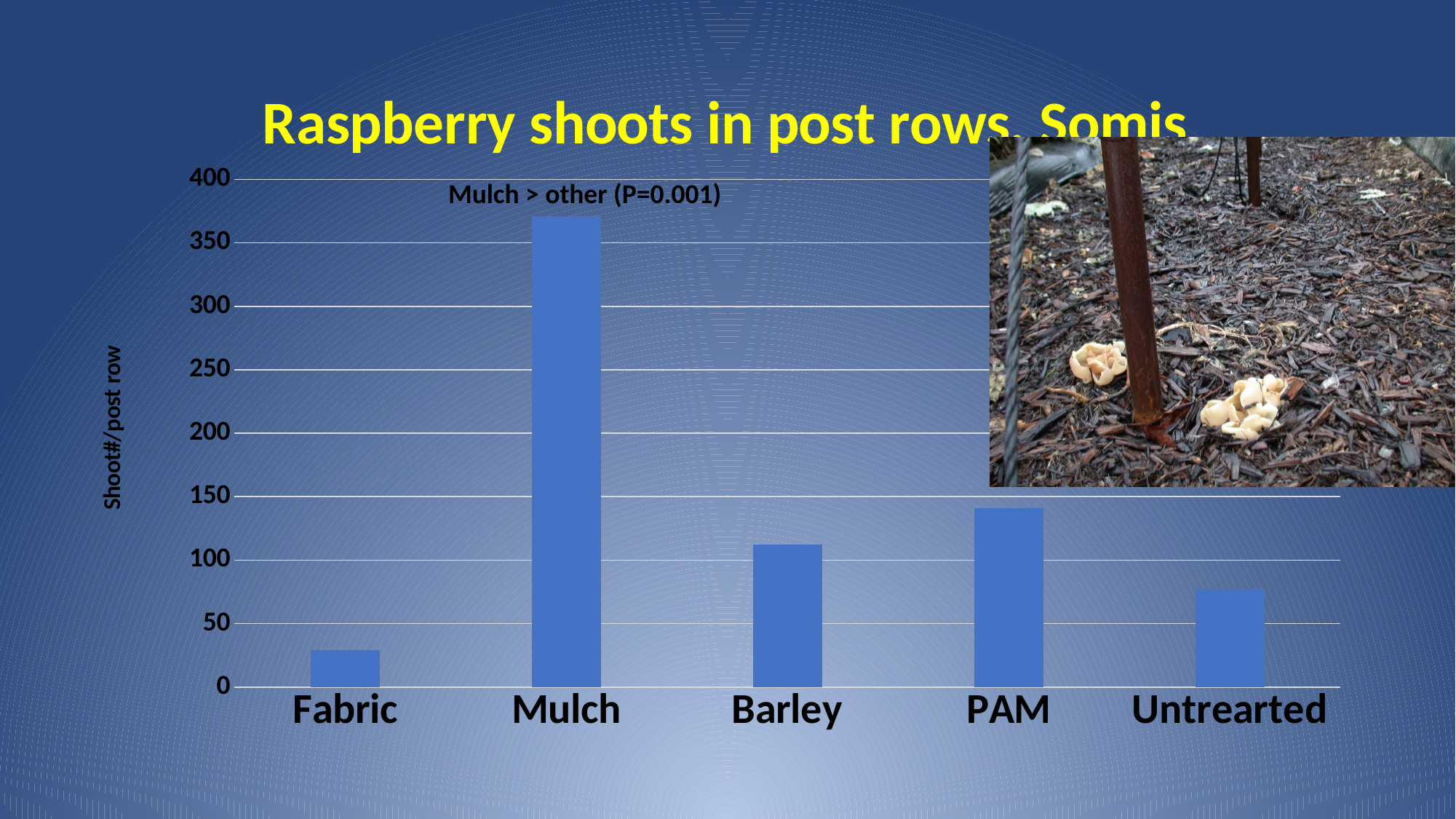
Is the value for Mulch greater or less than 350? greater What is the label on the vertical axis of the chart? Shoot#/post row Is the value for Fabric greater or less than 50? less Is the value for Barley greater or less than 100? greater Which has a higher value, Untrearted or Fabric? Untrearted Which category has the highest number of shoots per post row? Mulch Which has a higher value, PAM or Barley? PAM How many categories are shown on the x axis? 5 What kind of chart is shown on the slide? bar chart Which category has the lowest number of shoots per post row? Fabric